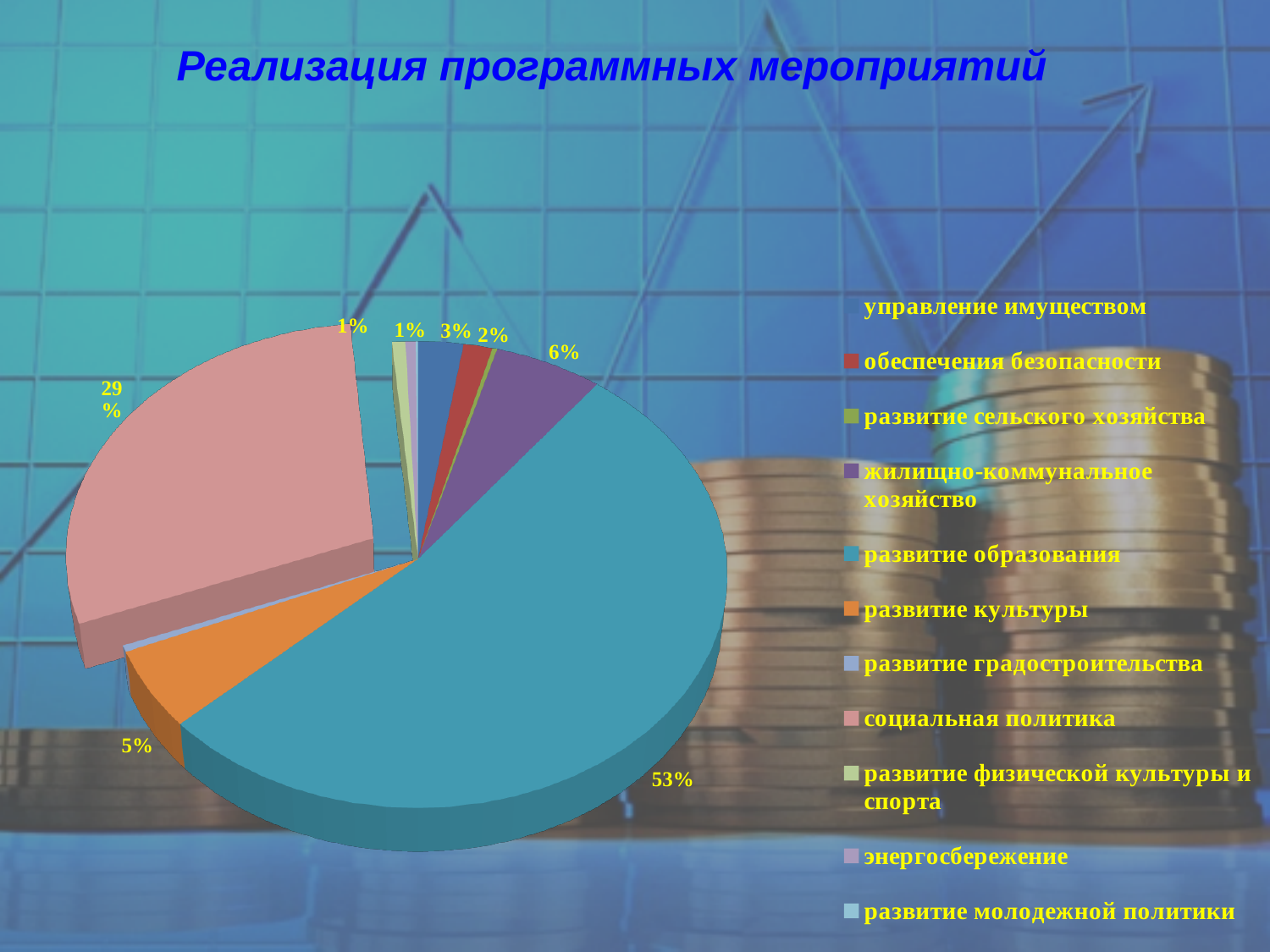
By how many percentage points does the share for развитие образования exceed the share for социальная политика? 24 What kind of chart is shown on the slide? pie chart Which category has the largest share of the pie? развитие образования What share of the pie does жилищно-коммунальное хозяйство have? 6% What share of the pie does развитие культуры have? 5% How many categories does the legend of the pie chart list? 11 What share of the pie does развитие образования have? 53% What colour is the slice for развитие образования? teal Which is larger, the share for развитие образования or the share for социальная политика? развитие образования Which is larger, the share for жилищно-коммунальное хозяйство or the share for развитие культуры? жилищно-коммунальное хозяйство What is the title of the chart on the slide? Реализация программных мероприятий